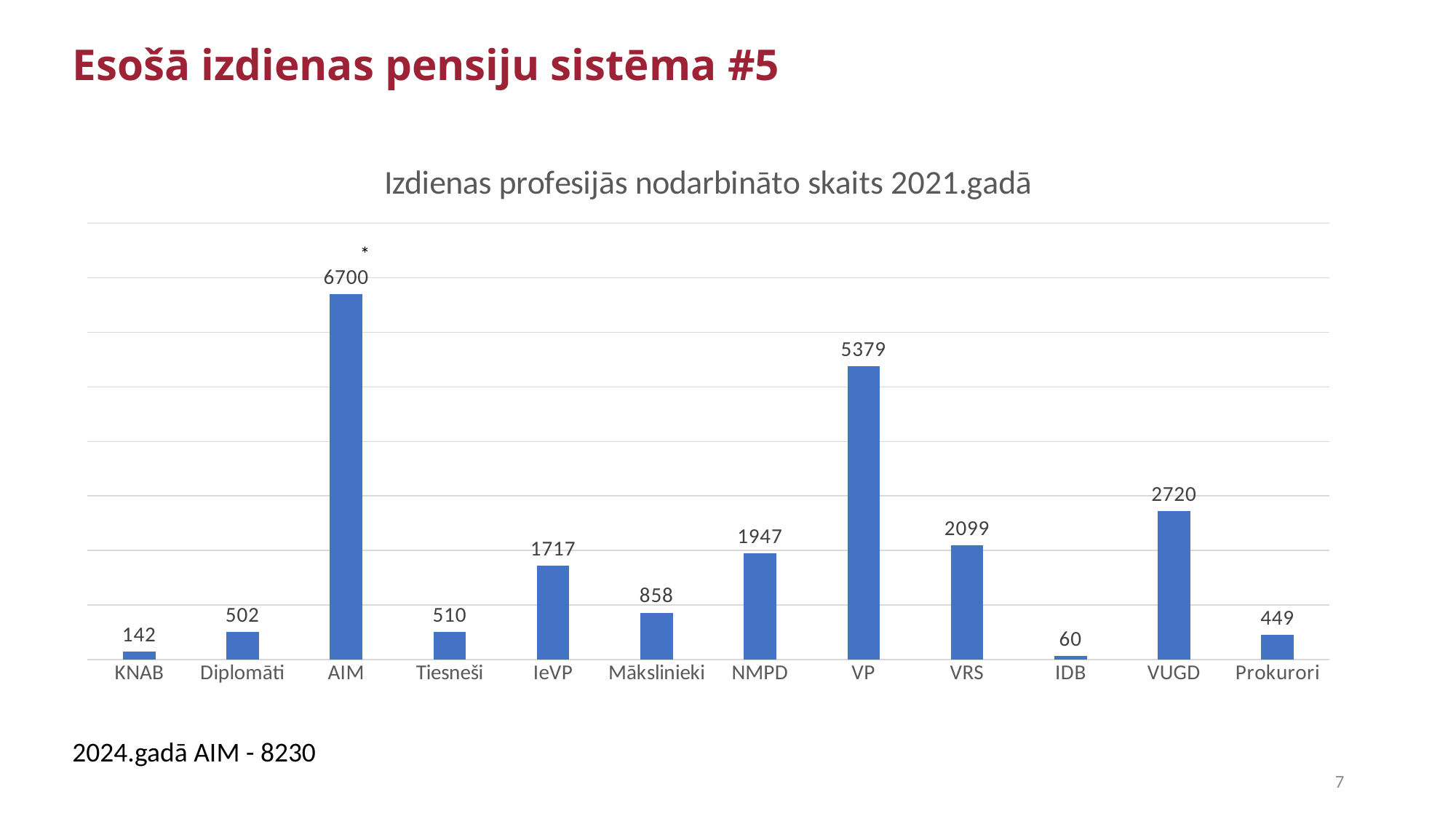
Which is larger, the value for NMPD or the value for IeVP? NMPD What is the value for VP? 5379 What is the value for Prokurori? 449 Which category has the highest value? AIM What is the title of the chart? Izdienas profesijās nodarbināto skaits 2021.gadā What is the value for Mākslinieki? 858 What is the difference between the values for VUGD and VRS? 621 Which category has the lowest value? IDB What is the value for AIM? 6700 What kind of chart is shown on the slide? Bar chart What is the difference between the values for AIM and VP? 1321 How many categories are shown on the x axis? 12